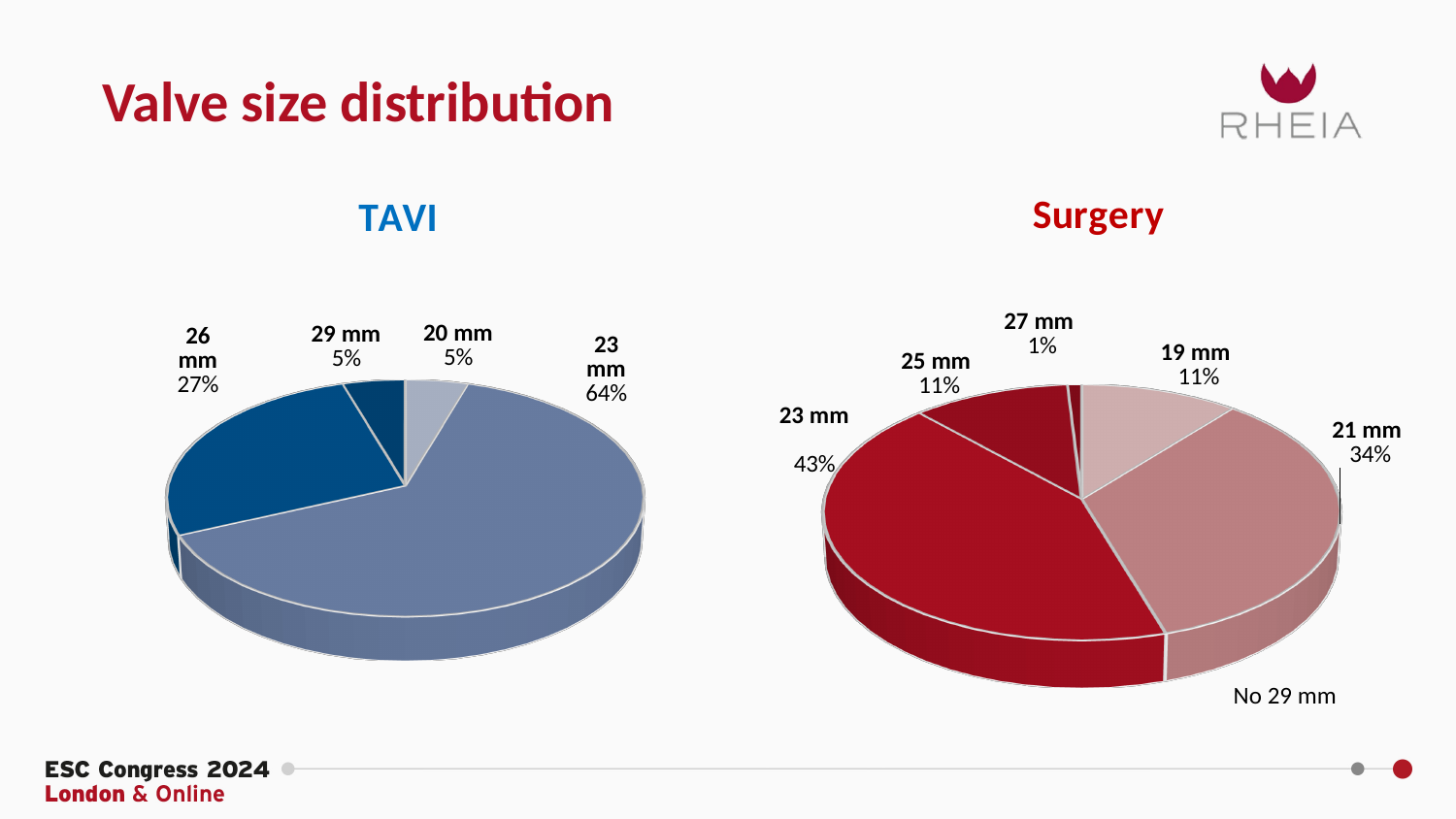
In the TAVI pie chart, what share of valves were 26 mm? 27% In the Surgery pie chart, which valve size has the smallest share? 27 mm What type of chart is used to show the valve size distribution for TAVI and Surgery? Pie chart In the Surgery pie chart, what share of valves were 27 mm? 1% In the Surgery pie chart, which valve size has the largest share? 23 mm How many valve size categories are shown in the Surgery pie chart? 5 How many valve size categories are shown in the TAVI pie chart? 4 In the Surgery pie chart, which is larger: the share of 23 mm valves or the share of 21 mm valves? 23 mm In the TAVI pie chart, what share of valves were 23 mm? 64% In the TAVI pie chart, what is the difference in percentage points between the 23 mm and 26 mm shares? 37 In the Surgery pie chart, what share of valves were 21 mm? 34% In the TAVI pie chart, which valve size has the largest share? 23 mm